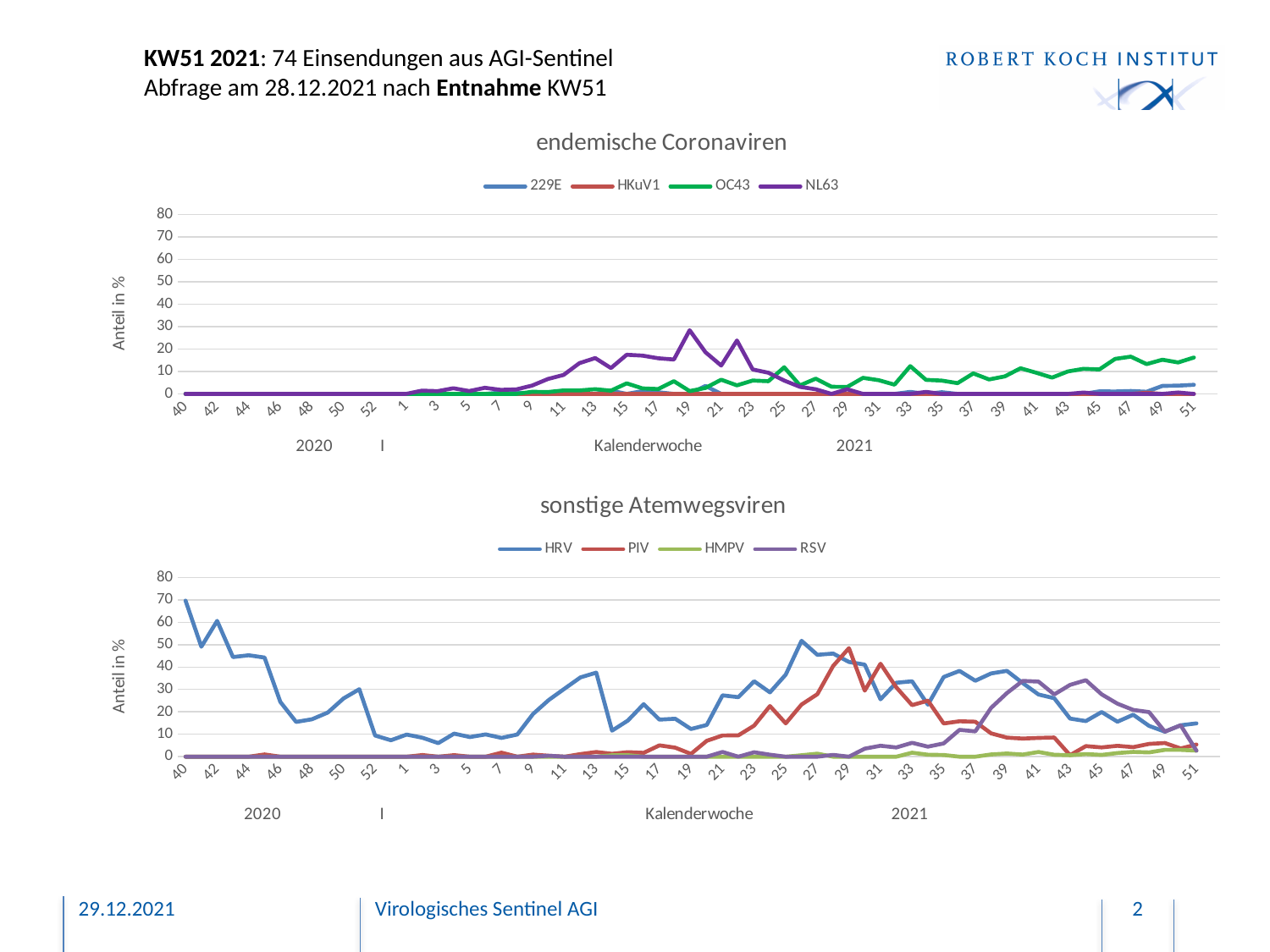
How many series does the legend of the top chart 'endemische Coronaviren' list? 4 In the top chart 'endemische Coronaviren', is the peak value of NL63 around calendar week 19 of 2021 greater or less than 20? greater In the bottom chart 'sonstige Atemwegsviren', which series stays lowest across the whole period? HMPV In the bottom chart 'sonstige Atemwegsviren', is the value of HRV at calendar week 40 of 2020 greater or less than 60? greater In the top chart 'endemische Coronaviren', which series reaches the highest value over the whole period? NL63 What kind of chart is the top chart titled 'endemische Coronaviren'? line chart In the top chart 'endemische Coronaviren', is the value of OC43 at calendar week 51 of 2021 greater or less than 10? greater In the bottom chart 'sonstige Atemwegsviren', which series has the highest value at calendar week 40 of 2020? HRV In the top chart 'endemische Coronaviren', which series is higher at calendar week 51 of 2021: OC43 or HKuV1? OC43 How many series does the legend of the bottom chart 'sonstige Atemwegsviren' list? 4 What is the label of the vertical axis on the top chart 'endemische Coronaviren'? Anteil in % What is the title of the bottom chart? sonstige Atemwegsviren